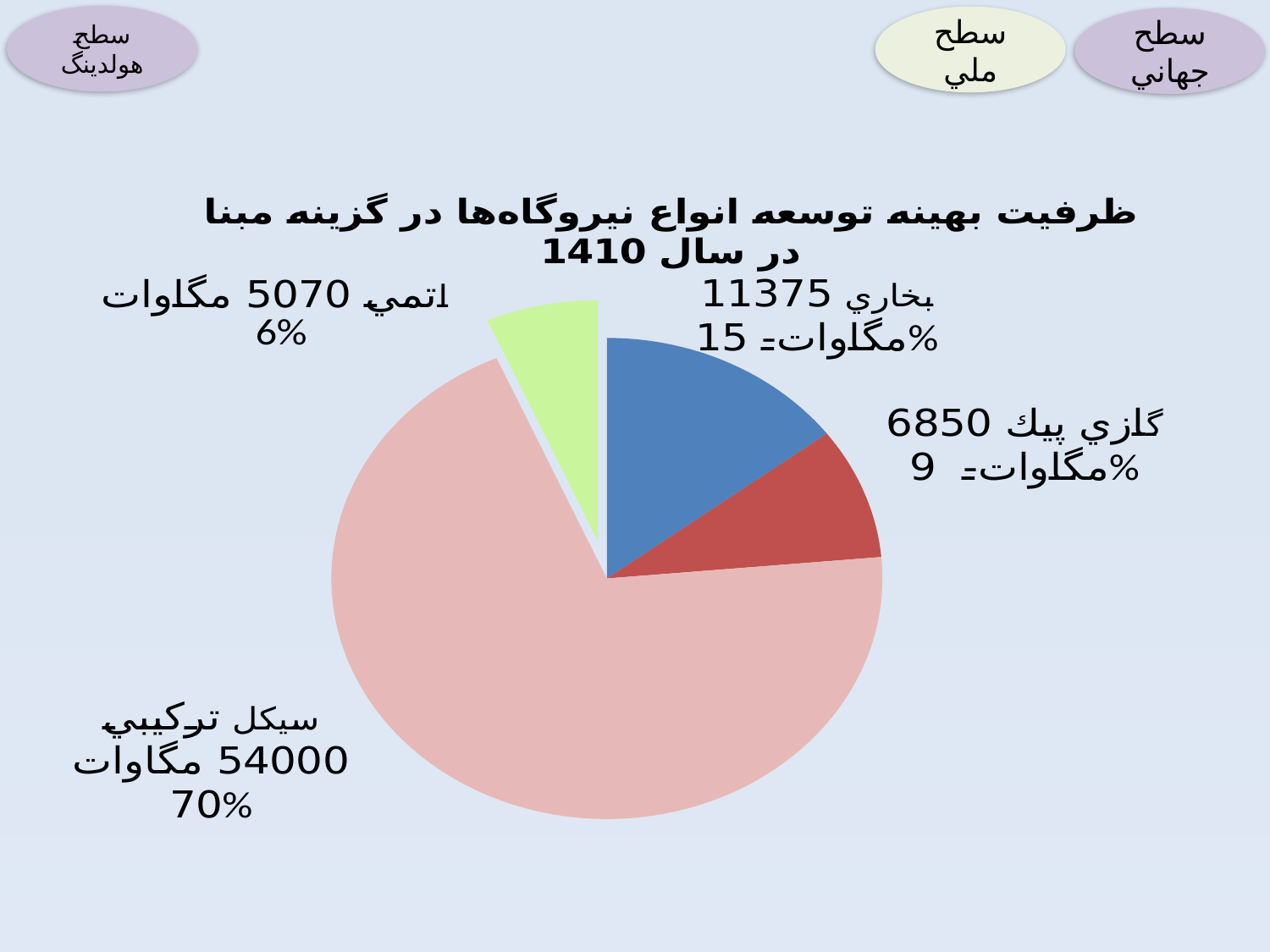
Which power plant type has the largest slice? سيكل تركيبي What is the capacity shown for اتمي (nuclear)? 5070 مگاوات What share of the pie does سيكل تركيبي (combined cycle) represent? 70% What is the capacity shown for سيكل تركيبي (combined cycle)? 54000 مگاوات What is the difference in capacity between بخاري and گازي پيك? 4525 مگاوات Which slice is larger, بخاري or گازي پيك? بخاري What share of the pie does اتمي (nuclear) represent? 6% How many slices does the pie chart have? 4 Which power plant type has the smallest slice? اتمي What kind of chart is shown on the slide? pie chart What is the capacity shown for گازي پيك (gas peak)? 6850 مگاوات What is the capacity shown for بخاري (steam)? 11375 مگاوات